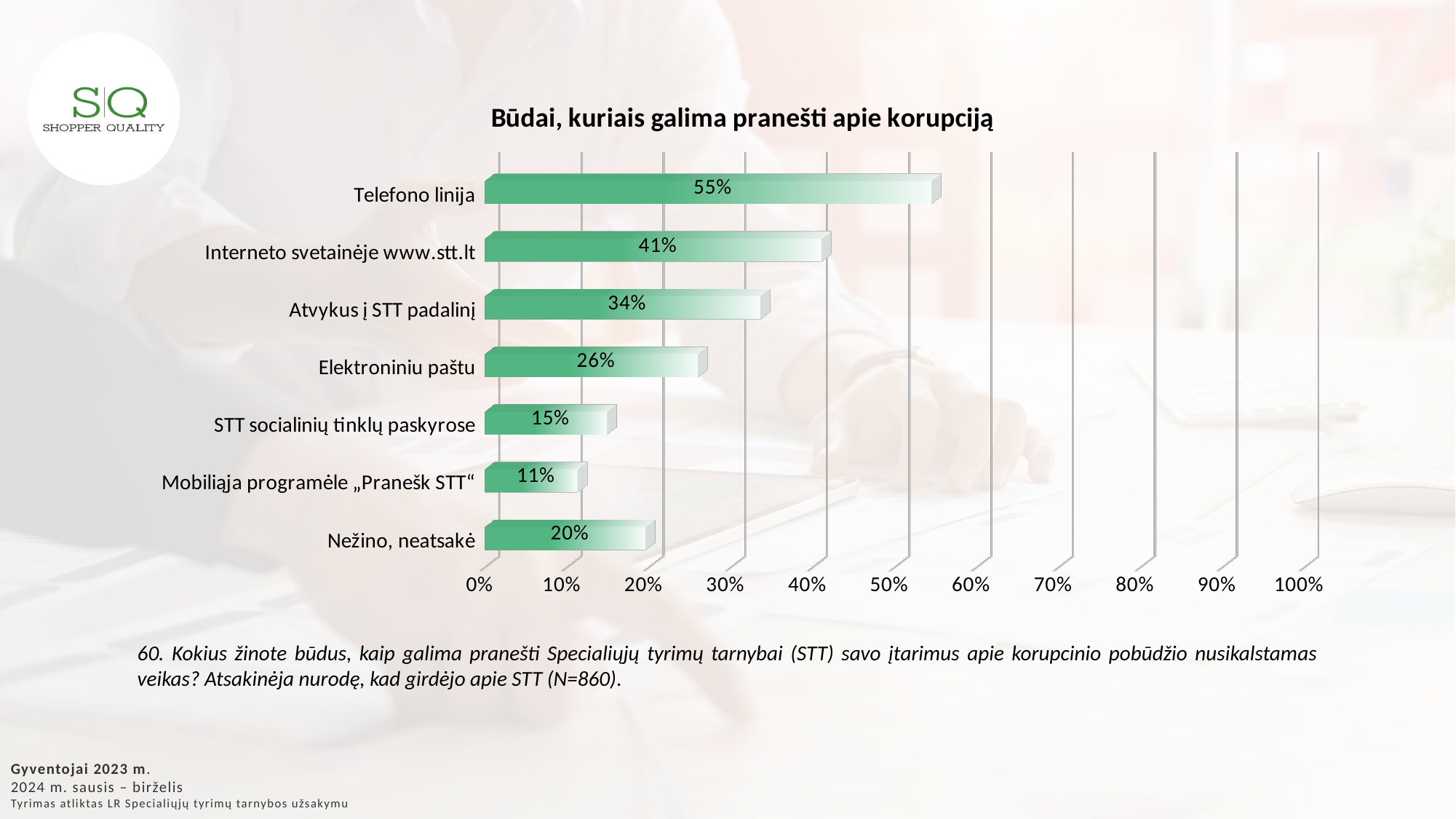
How many categories are shown in the chart? 7 What is the title of the chart? Būdai, kuriais galima pranešti apie korupciją What is the difference between the values for Telefono linija and Atvykus į STT padalinį? 21% What is the value for Elektroniniu paštu? 26% Is the value for Atvykus į STT padalinį greater or less than 30%? greater Which category has the highest value? Telefono linija Which is larger, the value for STT socialinių tinklų paskyrose or the value for Nežino, neatsakė? Nežino, neatsakė What is the value for Interneto svetainėje www.stt.lt? 41% What is the value for Nežino, neatsakė? 20% What is the value for Telefono linija? 55% Which category has the lowest value? Mobiliąja programėle „Pranešk STT“ What kind of chart is shown on the slide? bar chart